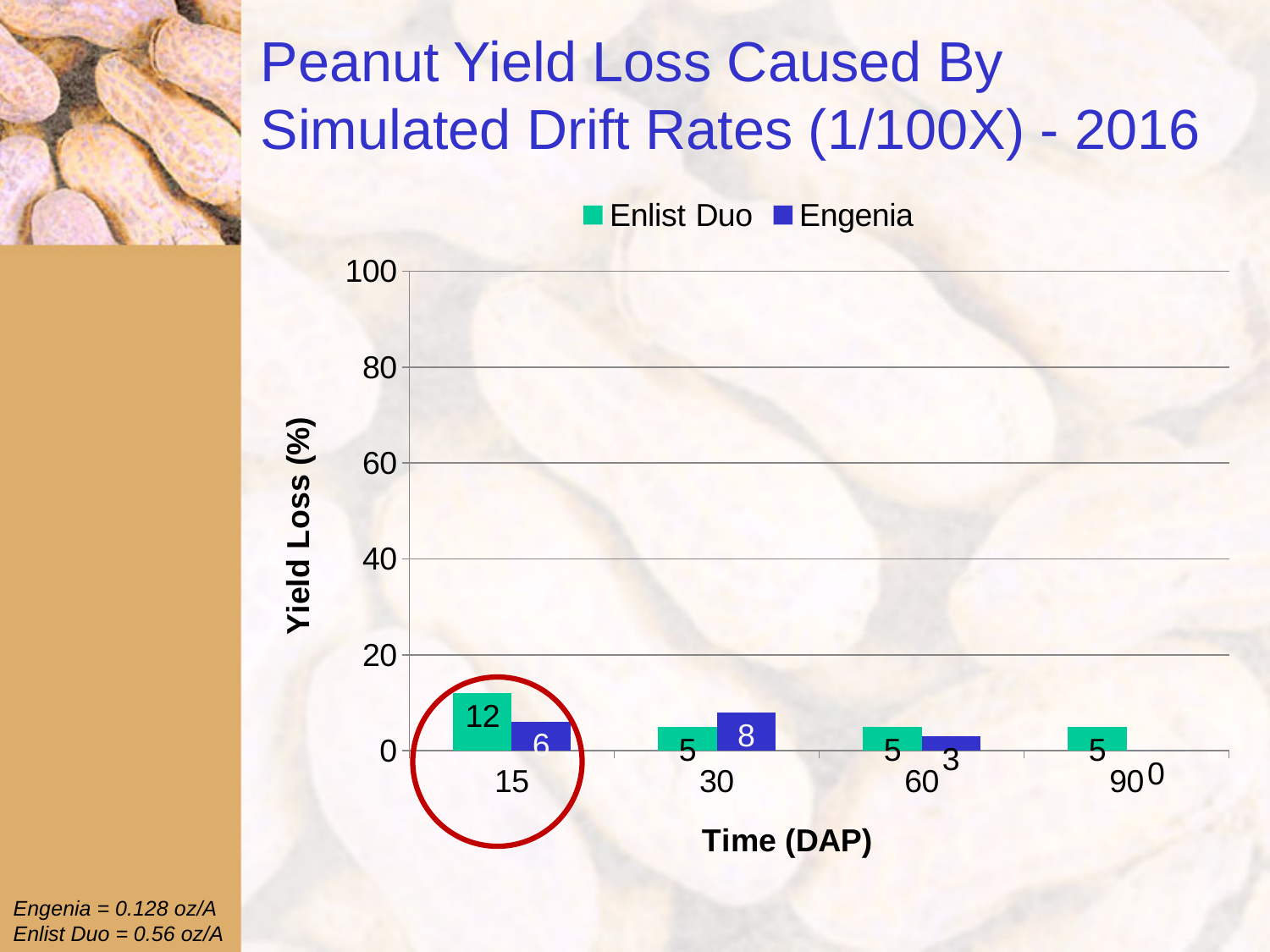
At 30 DAP, which has the larger yield loss, Enlist Duo or Engenia? Engenia How many time (DAP) categories are shown on the x axis? 4 What kind of chart is shown on the slide? bar chart How many series does the legend list? 2 At which time (DAP) is the Enlist Duo yield loss highest? 15 What is the yield loss for Enlist Duo at 15 DAP? 12 What is the yield loss for Engenia at 90 DAP? 0 Is the yield loss for Enlist Duo at 15 DAP greater or less than 20? less What is the yield loss for Engenia at 30 DAP? 8 What is the label of the y axis? Yield Loss (%) At which time (DAP) is the Engenia yield loss lowest? 90 What is the difference between the Enlist Duo and Engenia yield loss at 15 DAP? 6